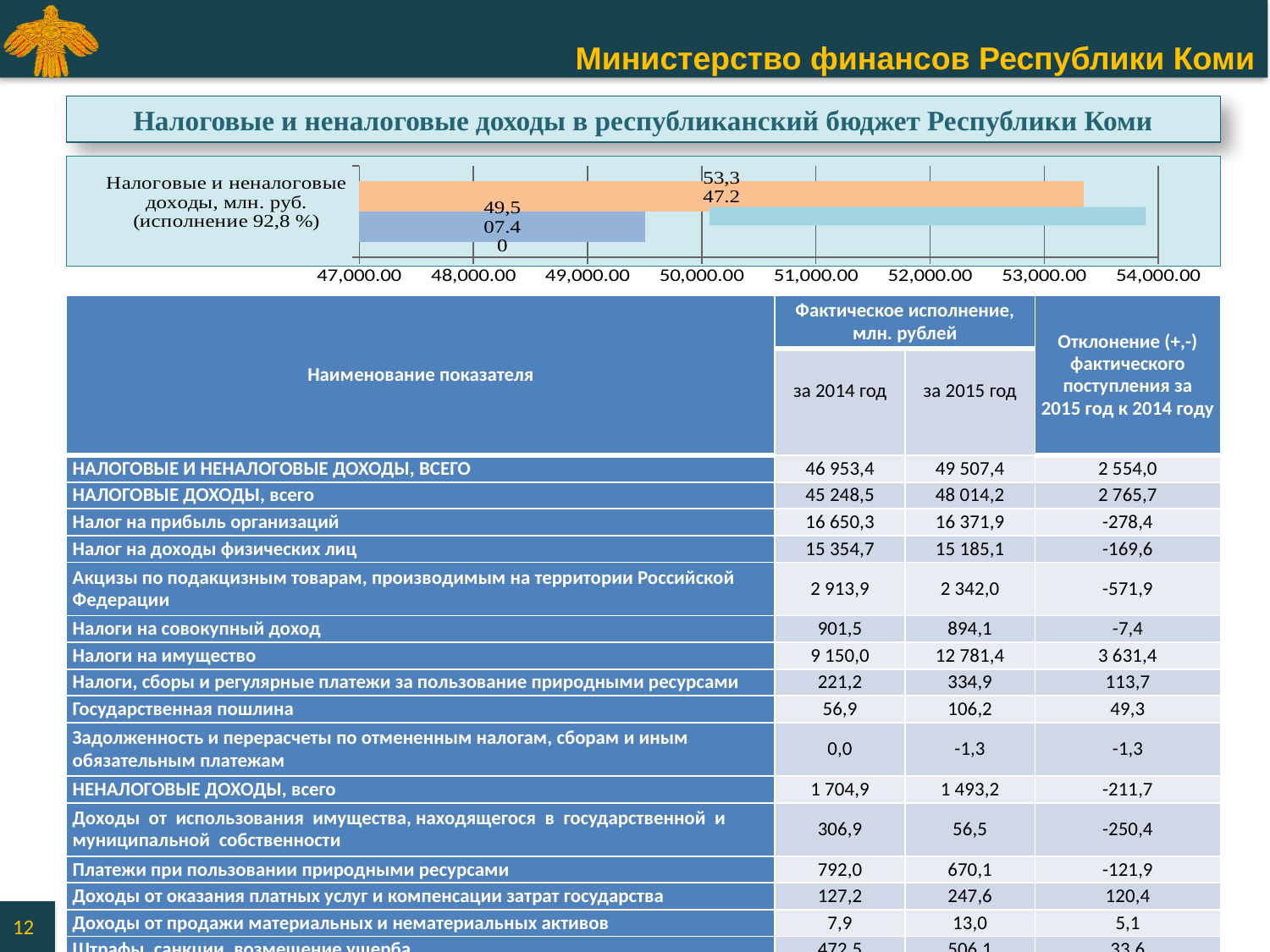
What kind of chart is shown on the slide? bar chart What value is labelled on the orange bar in the chart? 53,347.2 What execution percentage is stated in the chart's category label? 92,8 % Which bar is the shortest in the chart: the orange, the light blue, or the blue-grey one? the blue-grey bar Is the value of the orange bar greater or less than 52,000.00? greater Which is larger, the orange bar or the blue-grey bar? the orange bar Is the value of the blue-grey (shortest) bar greater or less than 50,000.00? less What is the lowest value shown on the chart's horizontal axis? 47,000.00